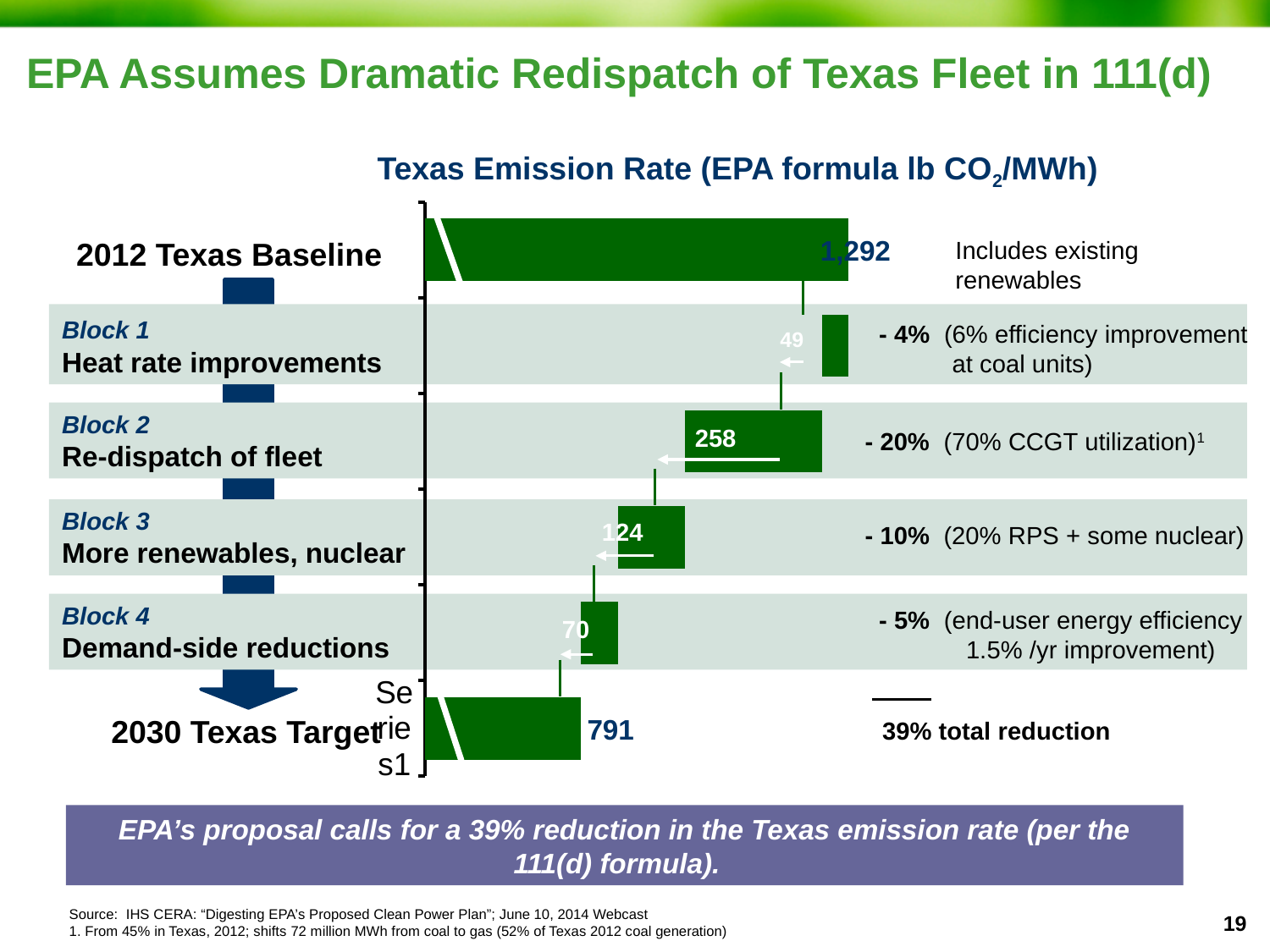
Which of the four blocks has the smallest reduction value? Block 1, Heat rate improvements What is the difference between the 2012 Texas Baseline and the 2030 Texas Target? 501 What is the title of the chart? Texas Emission Rate (EPA formula lb CO2/MWh) Which has a larger reduction value, Block 3 or Block 4? Block 3 What is the reduction value shown for Block 2, Re-dispatch of fleet? 258 Which of the four blocks has the largest reduction value? Block 2, Re-dispatch of fleet What is the value for the 2030 Texas Target? 791 What is the reduction value shown for Block 3, More renewables, nuclear? 124 What is the value for the 2012 Texas Baseline? 1,292 How many bars are plotted in the chart? 6 What is the reduction value shown for Block 1, Heat rate improvements? 49 What kind of chart is shown on the slide? Bar chart